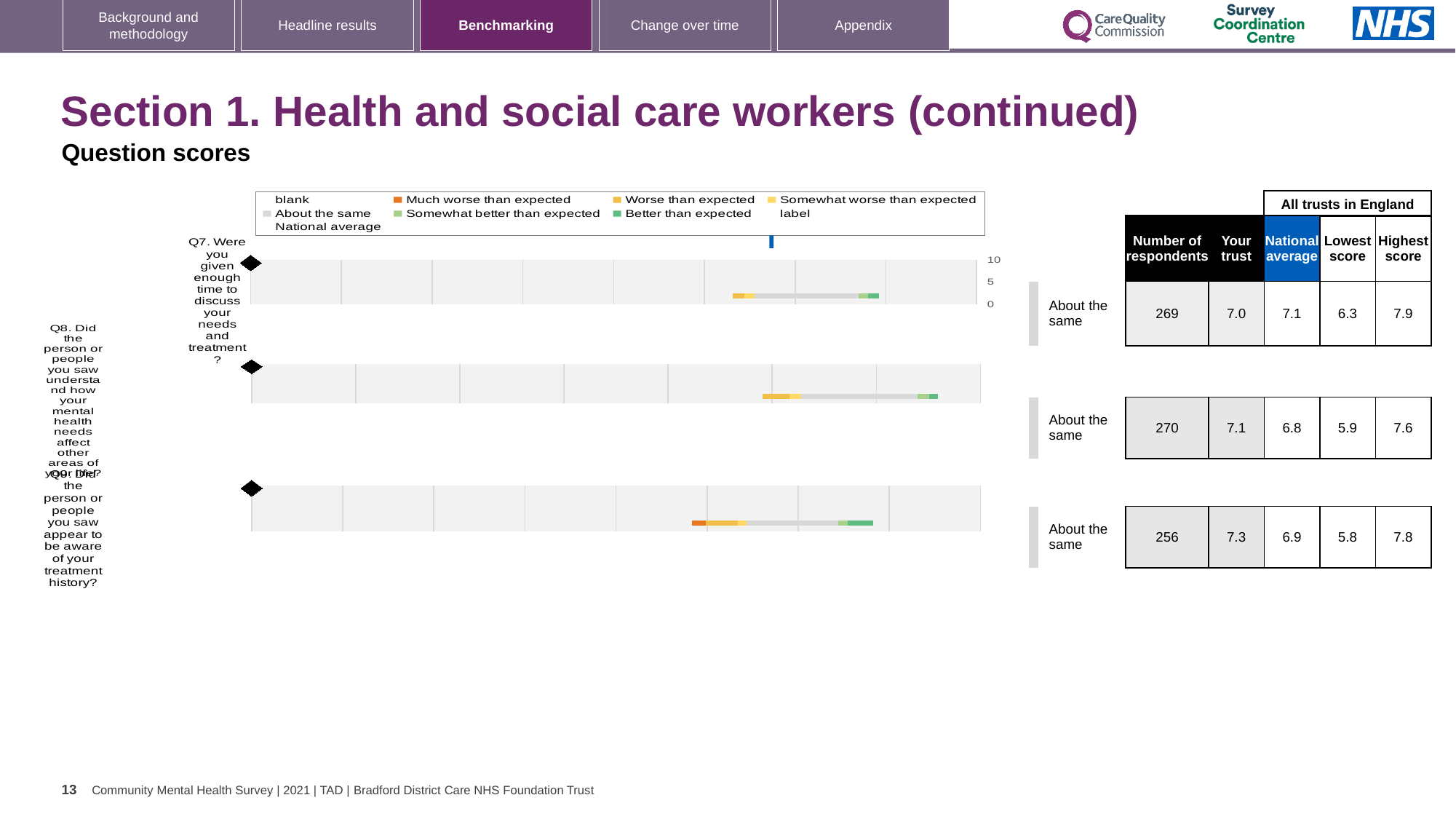
How many respondents answered Q7 (Were you given enough time to discuss your needs and treatment?)? 269 What is the 'Your trust' score for Q7? 7.0 For Q9, what is the difference between the 'Your trust' score and the national average? 0.4 Which question has the highest 'Your trust' score on this slide? Q9 What kind of chart is used to show the question scores? Bar chart What is the national average score for Q8 (Did the person or people you saw understand how your mental health needs affect other areas of your life?)? 6.8 Which question has the lowest 'Lowest score' among all trusts in England? Q9 For Q8, which is larger: the 'Your trust' score or the national average? Your trust What is the highest score across all trusts in England for Q9 (Did the person or people you saw appear to be aware of your treatment history?)? 7.8 What benchmark category is shown for Q7? About the same How many questions are charted on this slide? 3 For Q7, what is the difference between the highest score and the lowest score among all trusts in England? 1.6